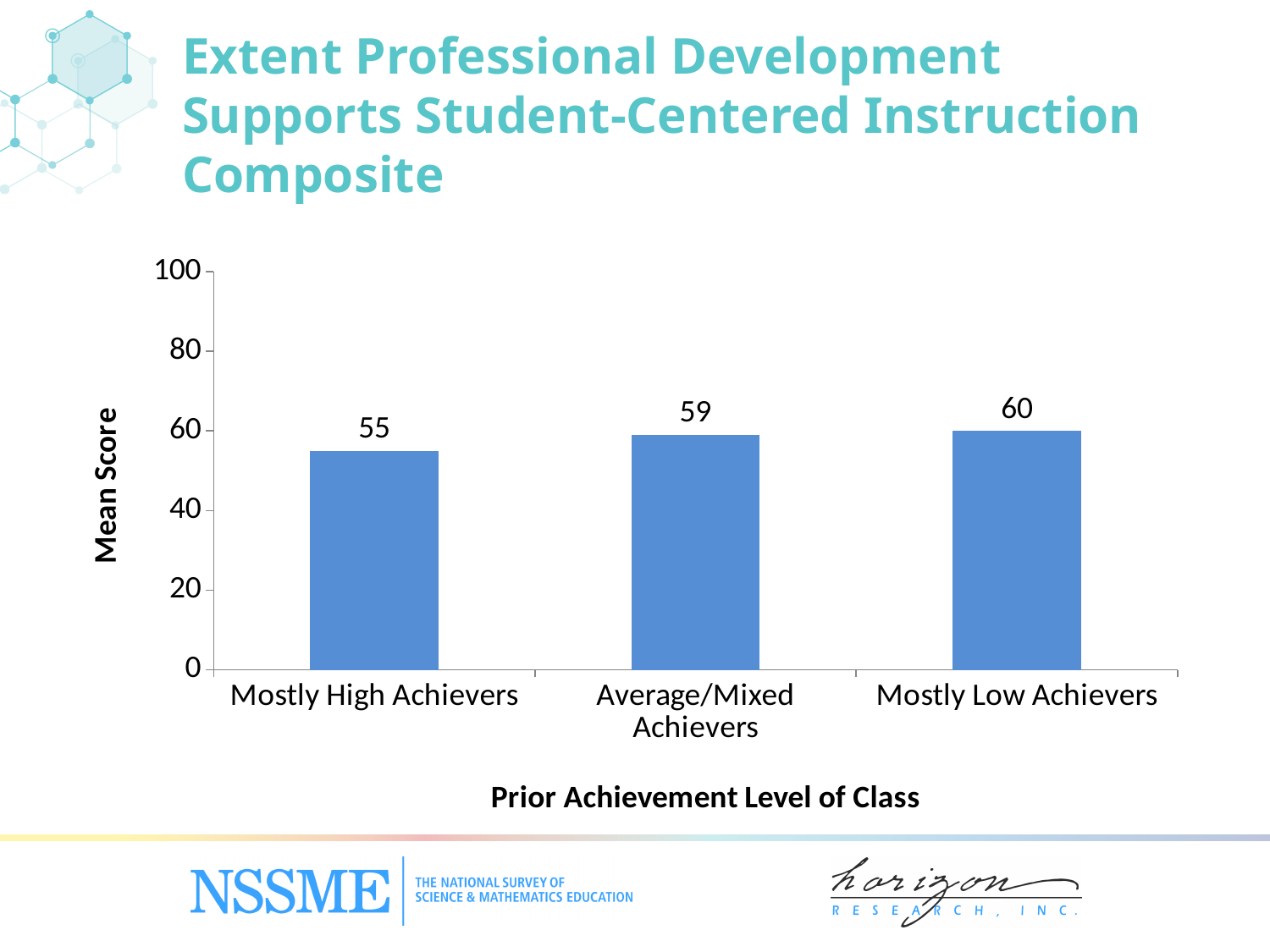
Which prior achievement level has the highest mean score? Mostly Low Achievers What kind of chart is shown on the slide? bar chart What is the mean score for Mostly Low Achievers? 60 What is the mean score for Mostly High Achievers? 55 What is the mean score for Average/Mixed Achievers? 59 What is the difference between the mean scores for Average/Mixed Achievers and Mostly High Achievers? 4 How many prior achievement level categories are shown on the chart? 3 Is the mean score for Mostly High Achievers greater or less than 60? less Which prior achievement level has the lowest mean score? Mostly High Achievers Which has a larger mean score, Mostly High Achievers or Average/Mixed Achievers? Average/Mixed Achievers What is the difference between the mean scores for Mostly Low Achievers and Mostly High Achievers? 5 What is the label of the x axis? Prior Achievement Level of Class